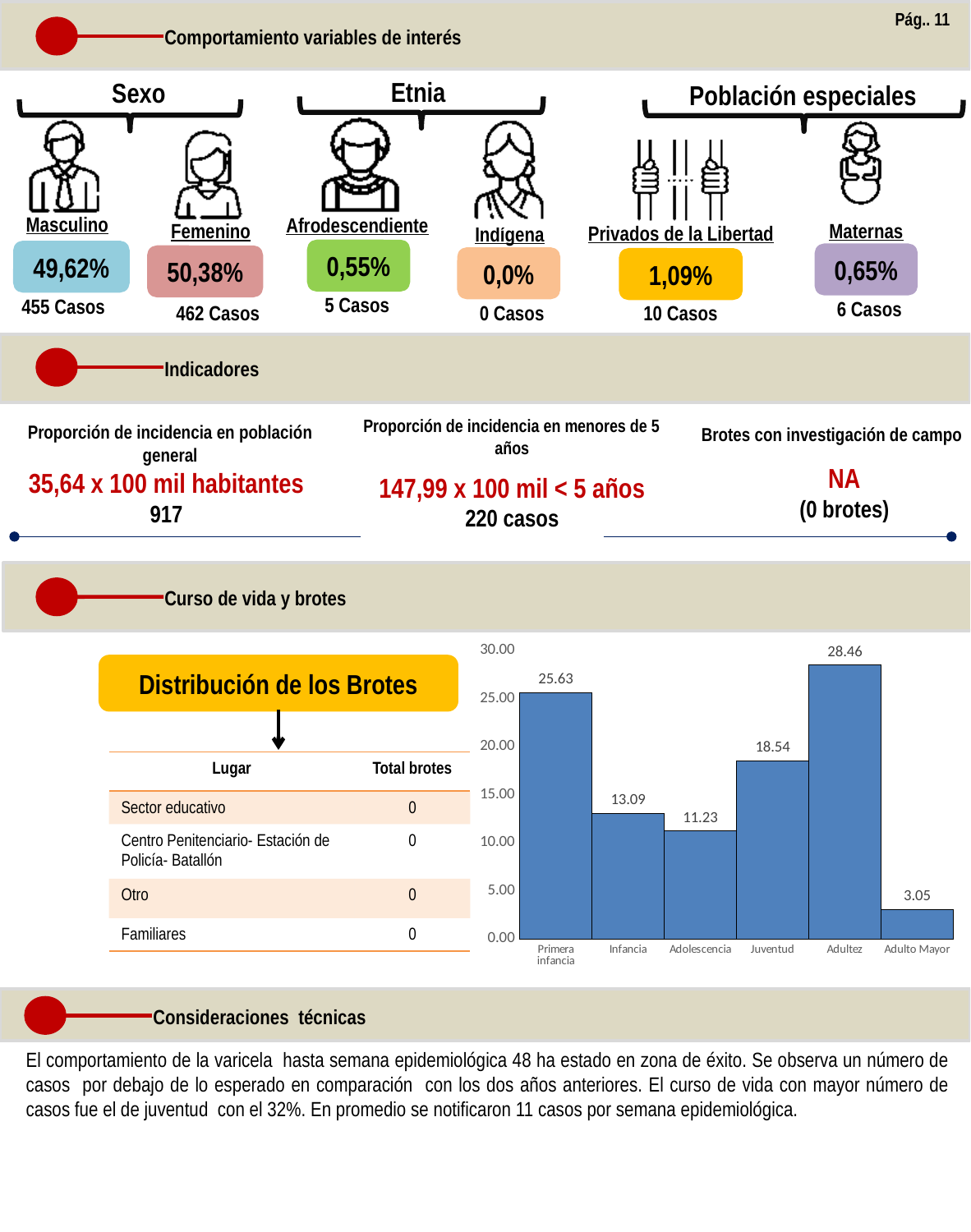
Which is larger in the bar chart, the value for Juventud or the value for Infancia? Juventud Which category has the highest value in the bar chart? Adultez What is the value for Adultez in the bar chart? 28.46 Which category has the lowest value in the bar chart? Adulto Mayor How many categories are shown on the x axis of the bar chart? 6 What is the value for Juventud in the bar chart? 18.54 What is the difference between the values for Adultez and Primera infancia in the bar chart? 2.83 What is the value for Primera infancia in the bar chart? 25.63 What kind of chart is shown in the Curso de vida y brotes section? Bar chart Is the value for Adolescencia in the bar chart greater or less than 15.00? less What is the value for Adulto Mayor in the bar chart? 3.05 What is the difference between the values for Infancia and Adolescencia in the bar chart? 1.86